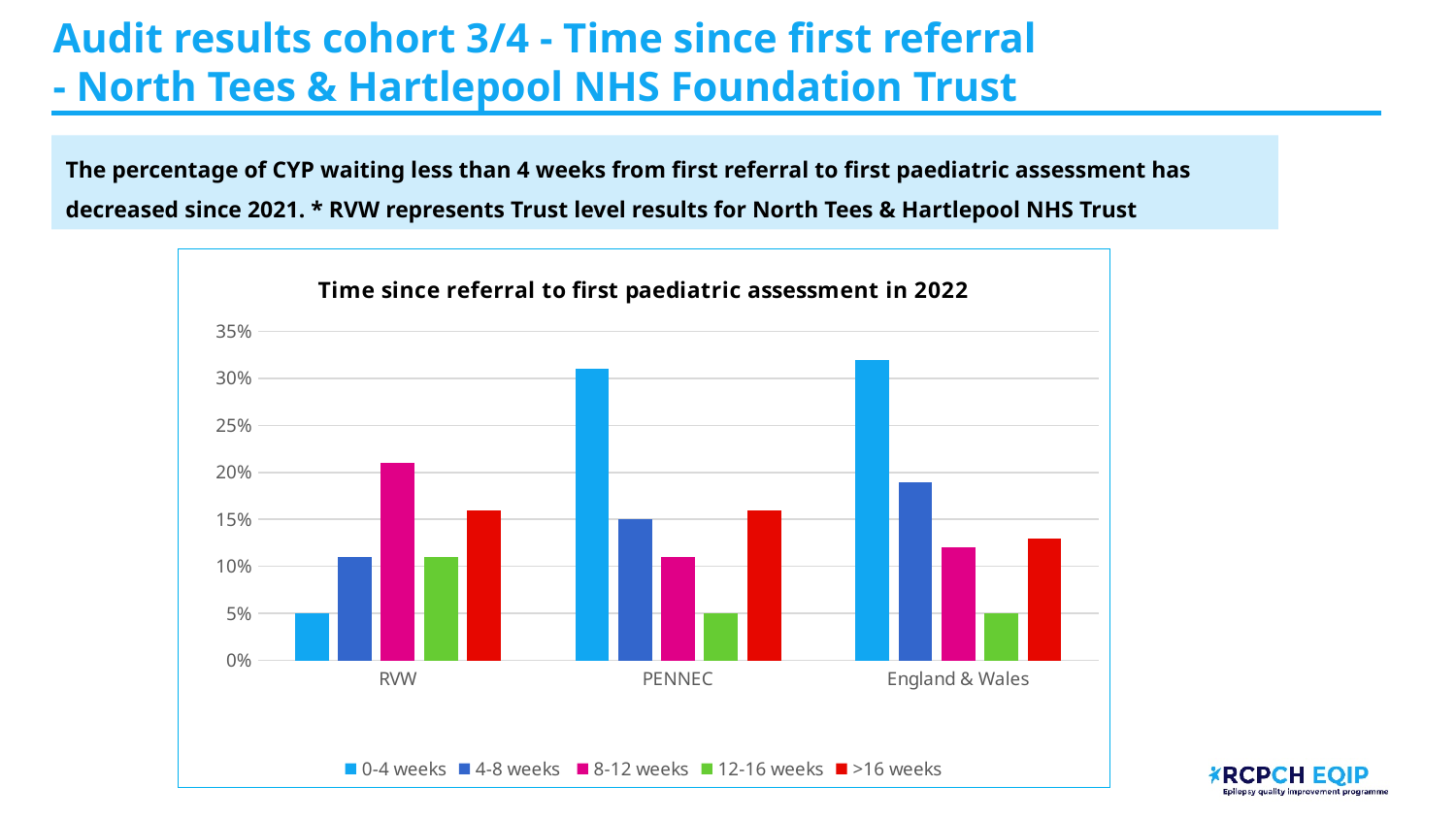
Which series has the lowest value for England & Wales? 12-16 weeks Which series has the highest value for RVW? 8-12 weeks Which is larger for PENNEC: the value for 0-4 weeks or the value for 4-8 weeks? 0-4 weeks What type of chart is shown on the slide? bar chart What is the value for 12-16 weeks for PENNEC? 5% How many series does the legend list? 5 Is the value for 8-12 weeks for RVW greater or less than 20%? greater Is the value for 0-4 weeks for PENNEC greater or less than 30%? greater What is the title of the chart? Time since referral to first paediatric assessment in 2022 How many categories are shown on the x axis? 3 Is the value for 4-8 weeks for England & Wales greater or less than 20%? less What is the value for 0-4 weeks for RVW? 5%